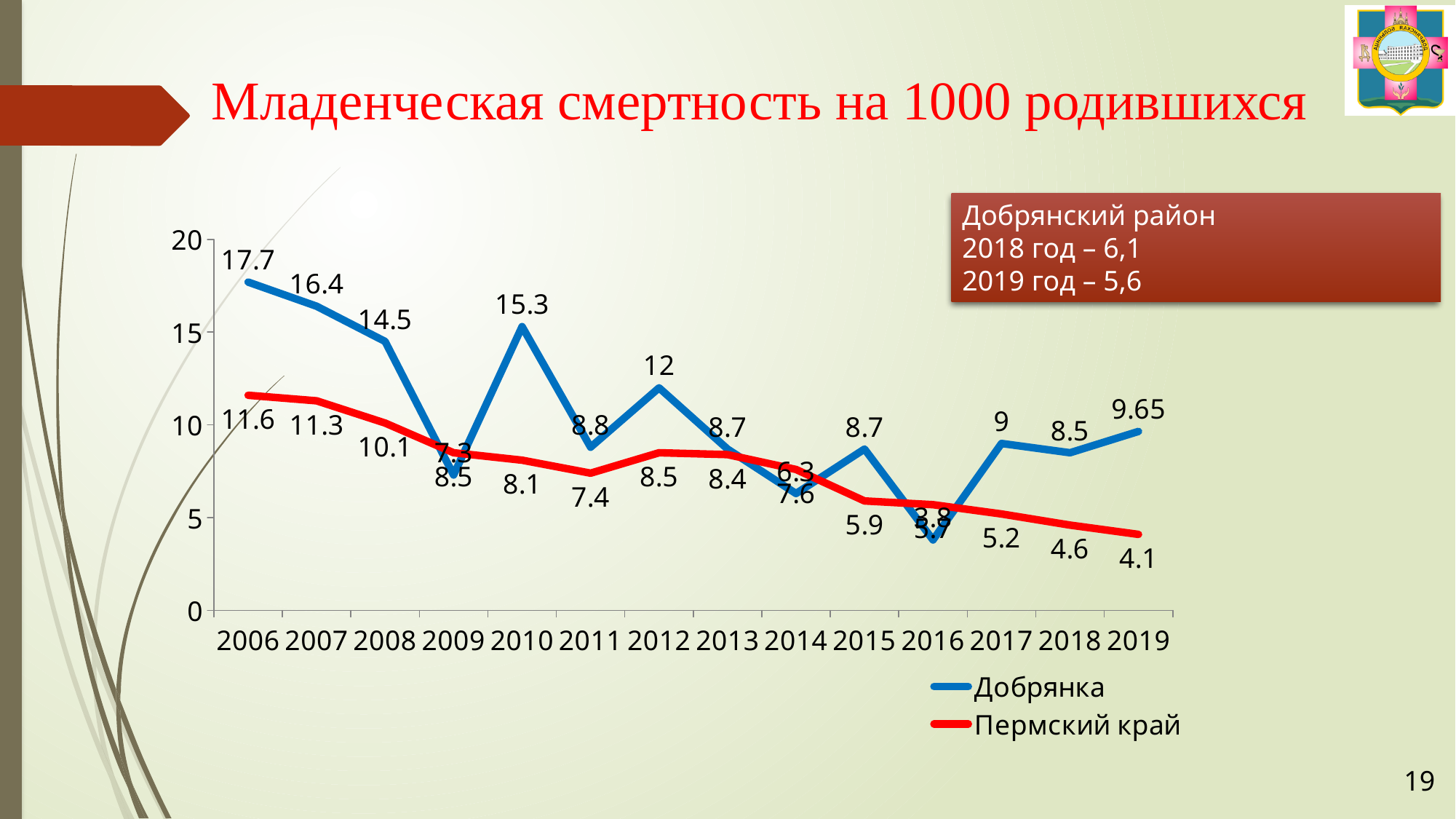
Does the Пермский край series generally rise or fall from 2006 to 2019? fall What kind of chart is shown on the slide? line chart In 2010, which series has the larger value, Добрянка or Пермский край? Добрянка Is the value for Добрянка in 2012 greater or less than 10? greater What is the difference between the Добрянка values for 2006 and 2007? 1.3 What is the value for Добрянка in 2010? 15.3 How many series does the legend list? 2 In which year is the Пермский край series at its lowest? 2019 What is the value for Пермский край in 2019? 4.1 In which year is the Добрянка series at its highest? 2006 What is the value for Добрянка in 2006? 17.7 How many years are shown on the x axis? 14